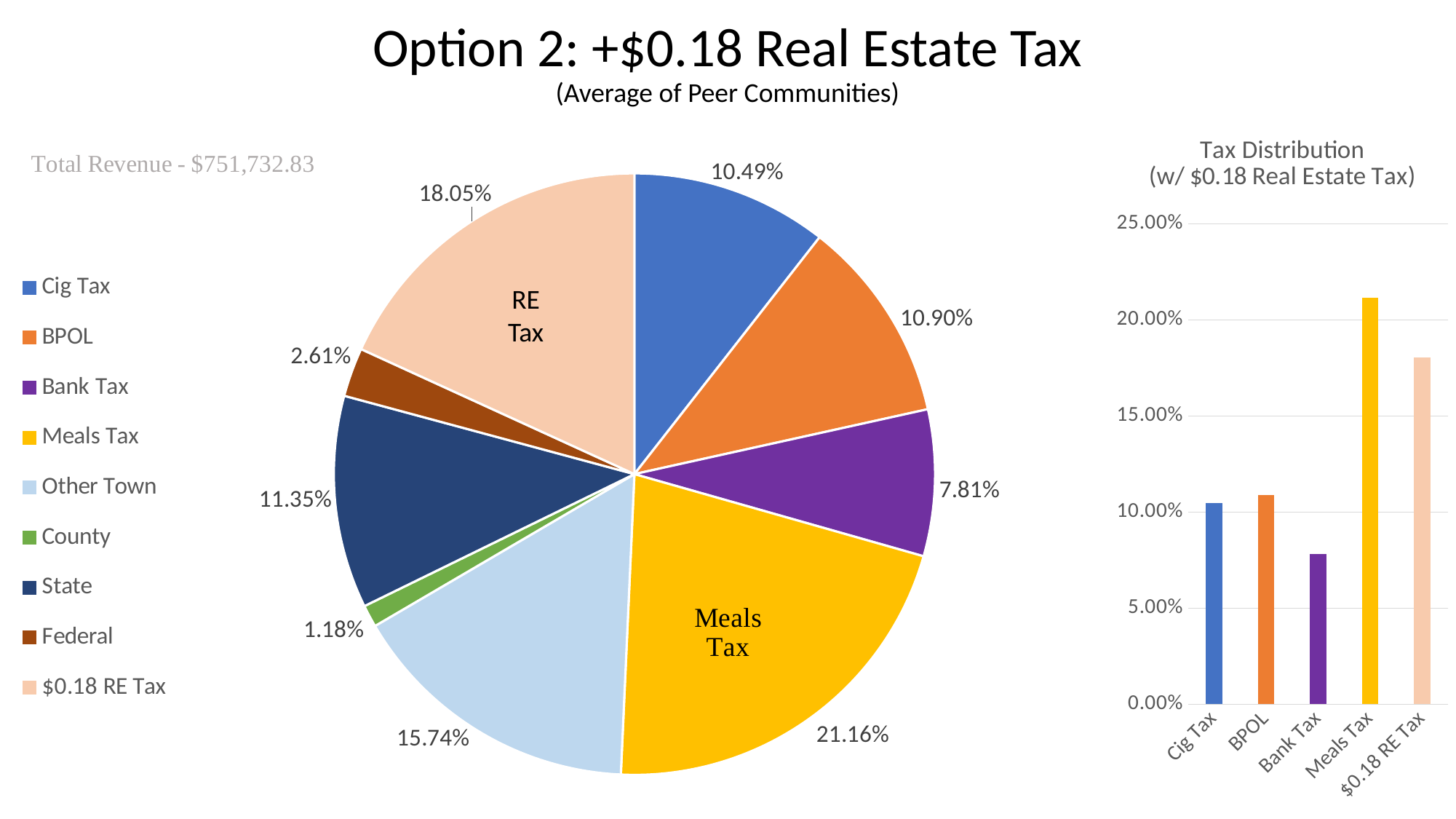
On the pie chart, which category has the largest slice? Meals Tax On the pie chart, which category has the smallest slice? County In the Tax Distribution bar chart, is the value for Meals Tax greater or less than 20.00%? greater On the pie chart, what percentage is shown for State? 11.35% On the pie chart, which is larger, BPOL or Cig Tax? BPOL On the pie chart, what percentage is shown for County? 1.18% What type of chart is the Tax Distribution chart on the right? Bar chart On the pie chart, what percentage is shown for the $0.18 RE Tax slice? 18.05% In the Tax Distribution bar chart, is the value for Bank Tax greater or less than 10.00%? less On the pie chart, what percentage is shown for Meals Tax? 21.16% On the pie chart, what is the difference between the Meals Tax and Other Town percentages? 5.42% How many categories does the pie chart's legend list? 9